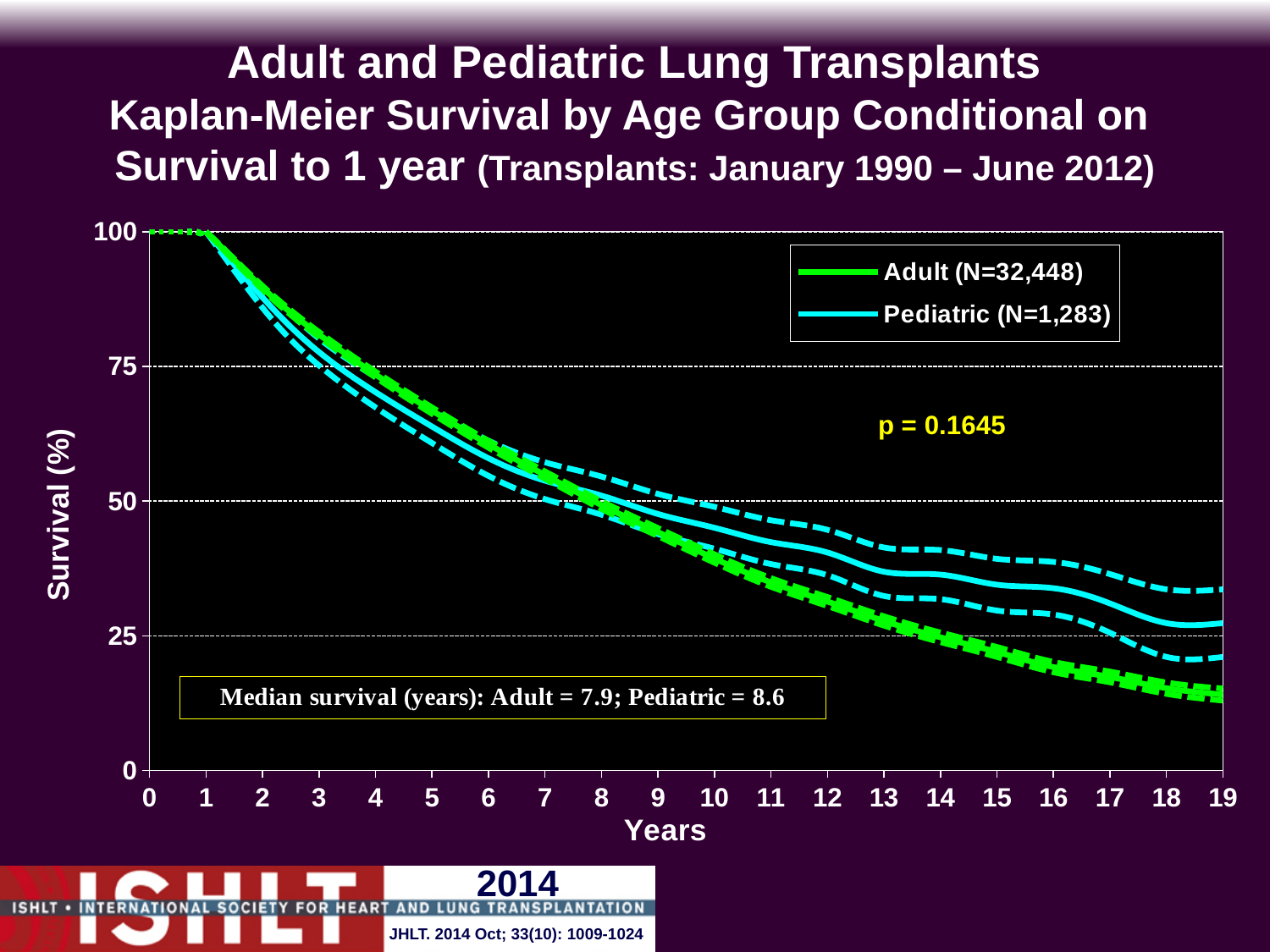
At 19 years, which group has the higher survival, Adult or Pediatric? Pediatric What is the median survival in years for the Adult group? 7.9 What is the N for the Adult group shown in the legend? 32,448 What kind of chart is shown on the slide? line chart What is the median survival in years for the Pediatric group? 8.6 What p-value is shown on the chart? p = 0.1645 What is the difference in median survival (years) between the Pediatric and Adult groups? 0.7 Is the Adult survival at 19 years greater or less than 25%? less How many series does the legend list? 2 Is the Adult survival at 3 years greater or less than 75%? greater What is the N for the Pediatric group shown in the legend? 1,283 Do the survival curves rise or fall as years increase? fall